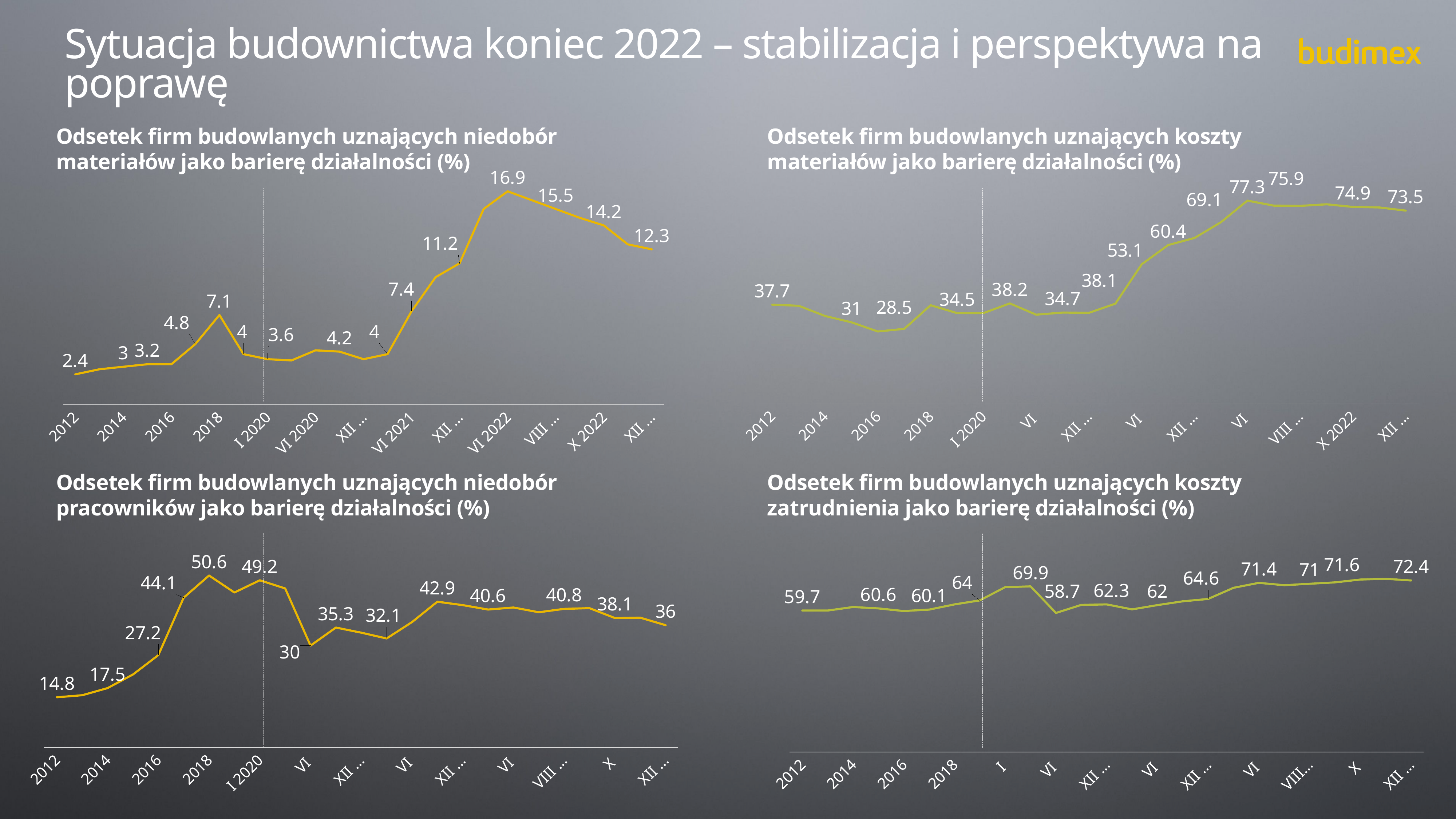
In the bottom-right chart (koszty zatrudnienia), what is the lowest value shown? 58.7 In the top-right chart (koszty materiałów), what is the highest value shown? 77.3 In the bottom-left chart (niedobór pracowników), what is the difference between the highest value (50.6) and the value for 2012 (14.8)? 35.8 In the top-left chart (niedobór materiałów), what is the value for 2012? 2.4 In the bottom-left chart (niedobór pracowników), what is the value for 2012? 14.8 In the top-left chart (niedobór materiałów), what is the highest value shown? 16.9 In the bottom-left chart (niedobór pracowników), what is the highest value shown? 50.6 How many charts are shown on the slide? 4 What kind of chart is the top-left chart titled 'Odsetek firm budowlanych uznających niedobór materiałów jako barierę działalności (%)'? Line chart In the bottom-right chart (koszty zatrudnienia), what is the value of the last data point? 72.4 In the top-right chart (koszty materiałów), what is the value of the last data point? 73.5